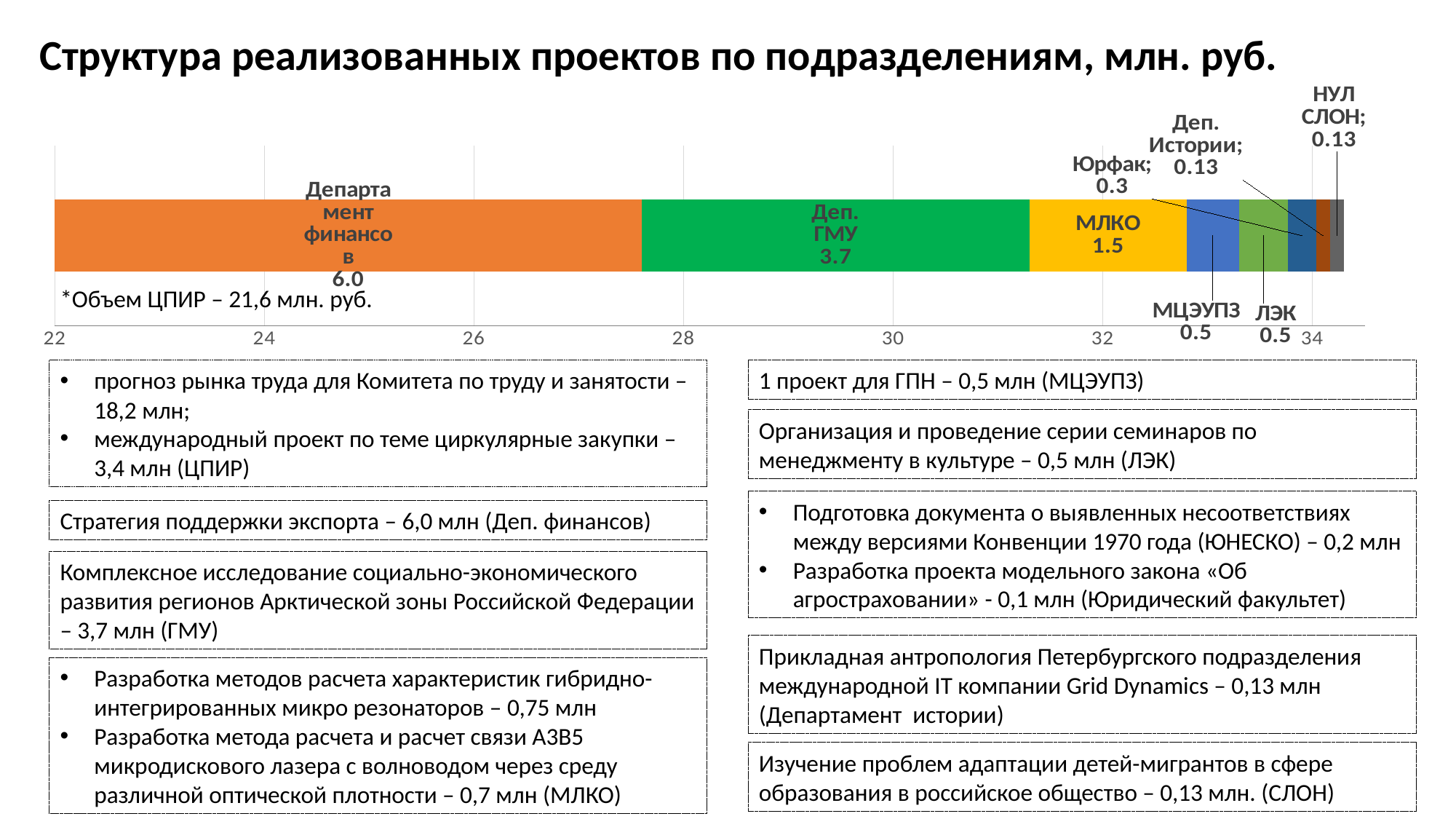
Which is larger, the value for Деп. ГМУ or the value for МЛКО? Деп. ГМУ What is the value for НУЛ СЛОН? 0.13 What is the difference between the values for Департамент финансов and Деп. ГМУ? 2.3 What kind of chart is shown on the slide? Stacked bar chart What is the value for Юрфак? 0.3 What is the difference between the values for МЛКО and Юрфак? 1.2 What is the title of the chart? Структура реализованных проектов по подразделениям, млн. руб. What is the value for Департамент финансов? 6.0 How many labelled segments does the stacked bar contain? 8 What is the value for Деп. ГМУ? 3.7 What is the value for МЛКО? 1.5